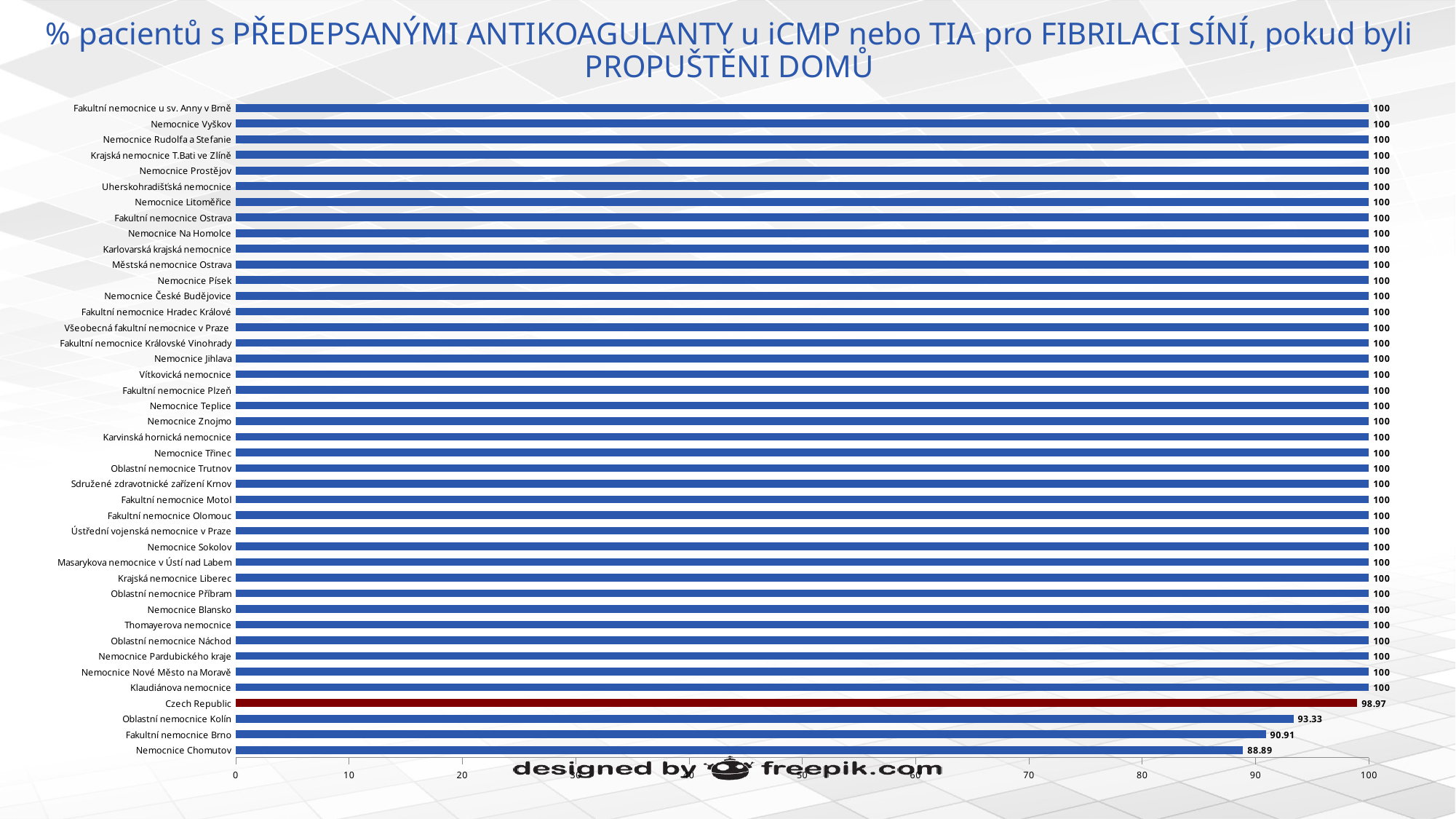
What kind of chart is shown on the slide? bar chart What is the difference between the values for Czech Republic and Fakultní nemocnice Brno? 8.06 What is the value for Oblastní nemocnice Kolín? 93.33 What is the value for Czech Republic? 98.97 Which bar is shown in a different colour (dark red) from the others? Czech Republic Which is larger, the value for Oblastní nemocnice Kolín or the value for Fakultní nemocnice Brno? Oblastní nemocnice Kolín Is the value for Nemocnice Chomutov greater or less than 90? less Which category has the lowest value? Nemocnice Chomutov What is the value for Fakultní nemocnice Motol? 100 What is the value for Fakultní nemocnice Brno? 90.91 What is the value for Nemocnice Chomutov? 88.89 What is the difference between the values for Oblastní nemocnice Kolín and Nemocnice Chomutov? 4.44